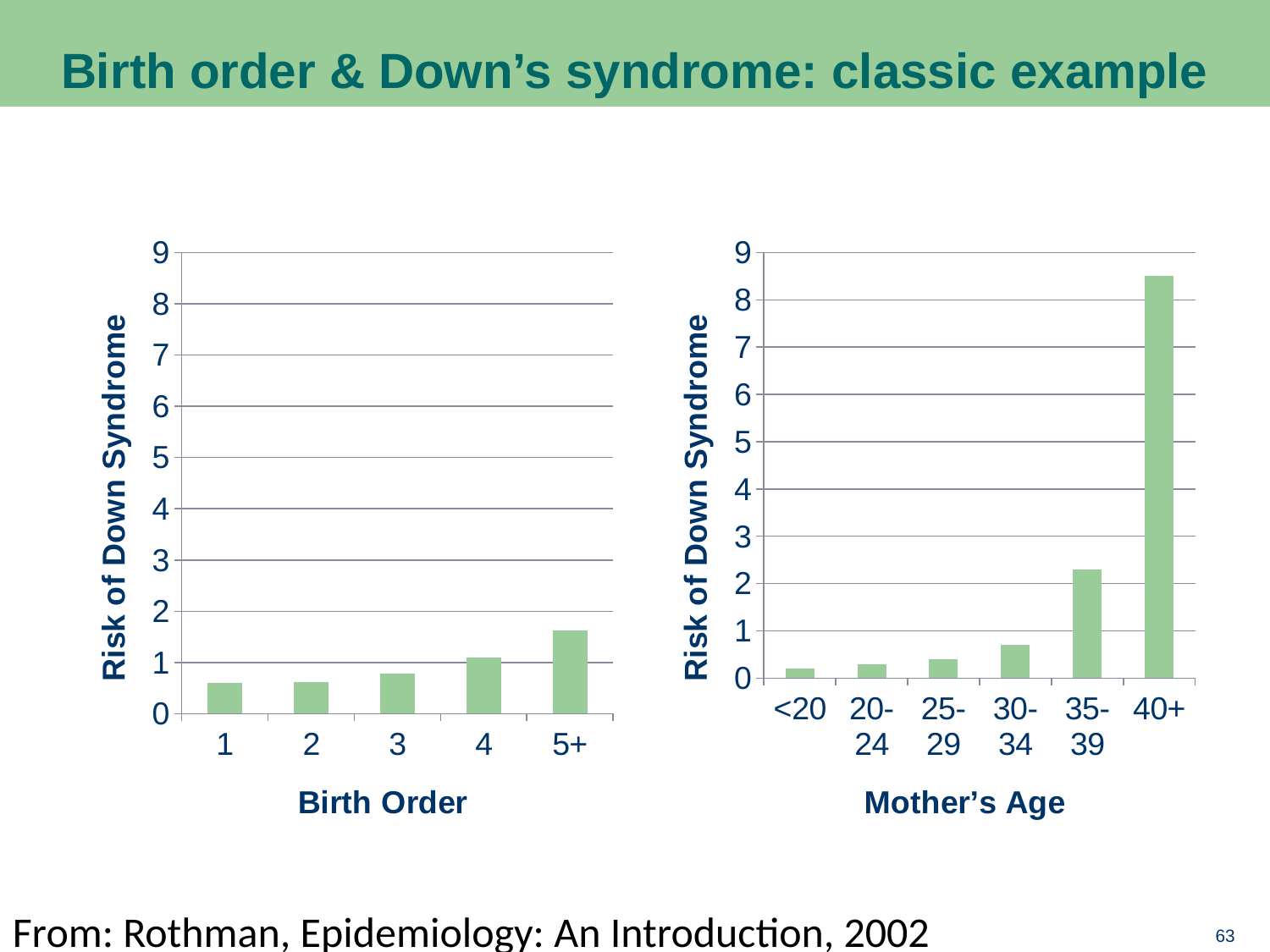
What is the y-axis title of the Mother's Age chart on the right? Risk of Down Syndrome In the Birth Order chart on the left, is the value for birth order 5+ greater or less than 1? greater In the Mother's Age chart on the right, which age group has the highest risk of Down syndrome? 40+ In the Birth Order chart on the left, which birth order has the highest risk of Down syndrome? 5+ In the Mother's Age chart on the right, how many age groups are shown on the x axis? 6 In the Birth Order chart on the left, do the values rise or fall as birth order increases? rise In the Birth Order chart on the left, how many birth order categories are shown on the x axis? 5 In the Birth Order chart on the left, what kind of chart is shown? bar chart In the Mother's Age chart on the right, is the value for the 40+ age group greater or less than 8? greater In the Mother's Age chart on the right, which has the larger value: the 35-39 age group or the 30-34 age group? 35-39 In the Mother's Age chart on the right, which age group has the lowest risk of Down syndrome? <20 In the Birth Order chart on the left, is the value for birth order 3 greater or less than 1? less